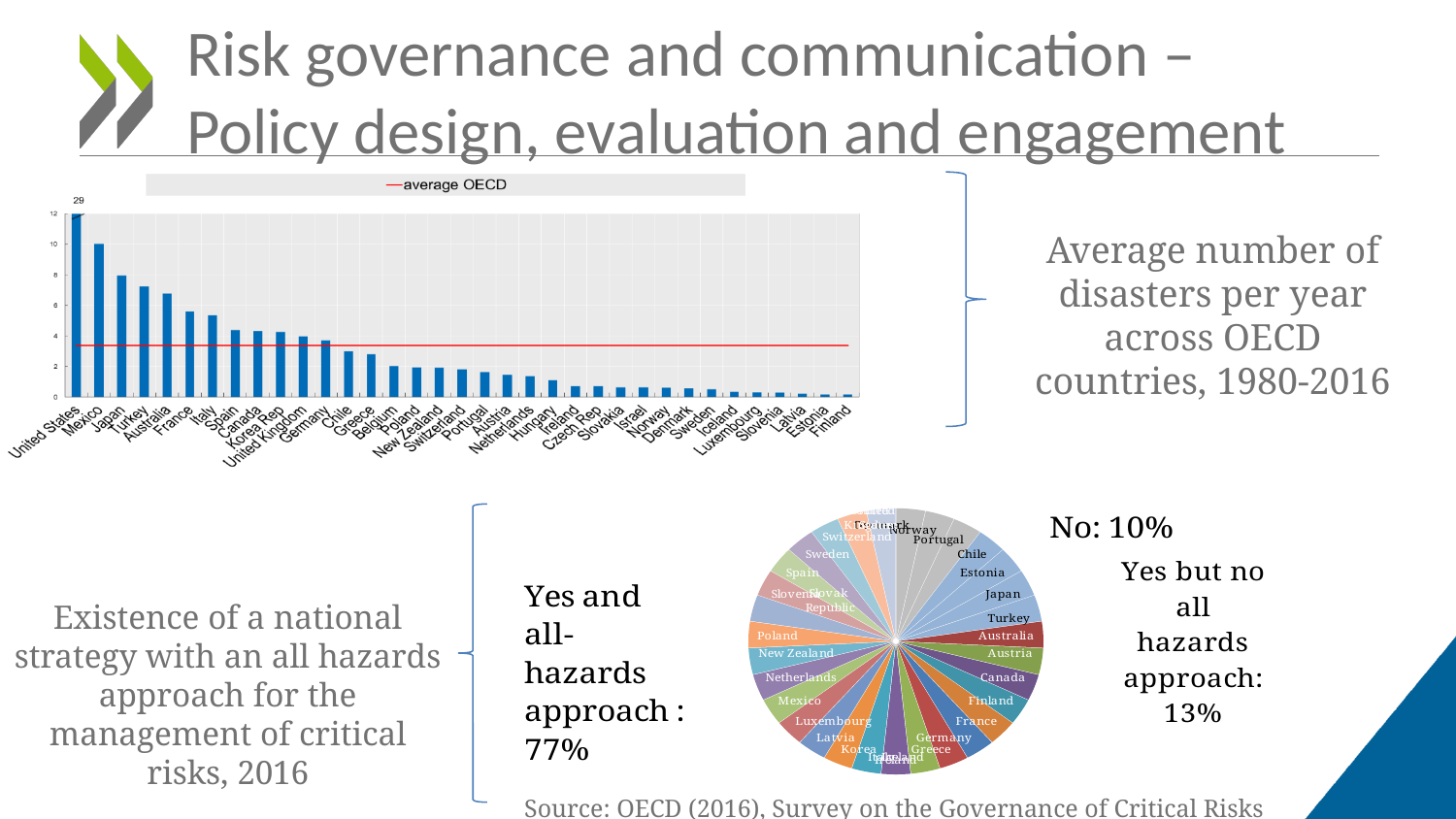
What kind of chart is the bottom chart about the existence of a national strategy with an all hazards approach? pie chart What kind of chart is the top chart showing the average number of disasters per year across OECD countries? bar chart According to the bottom pie chart, what share of countries answered 'Yes and all-hazards approach'? 77% In the top bar chart, what does the red horizontal line represent according to the legend? average OECD In the top bar chart, what value is printed above the bar for the United States? 29 In the top bar chart, which has the larger value, Mexico or Japan? Mexico In the top bar chart, is the value for Mexico greater or less than 8? greater In the top bar chart of average disasters per year, which country has the highest value? United States In the top bar chart, which has the larger value, Turkey or France? Turkey In the top bar chart, do the values rise or fall moving from left to right along the x axis? fall In the top bar chart, is the value for Poland greater or less than 4? less In the top bar chart, is the value for Chile greater or less than 4? less